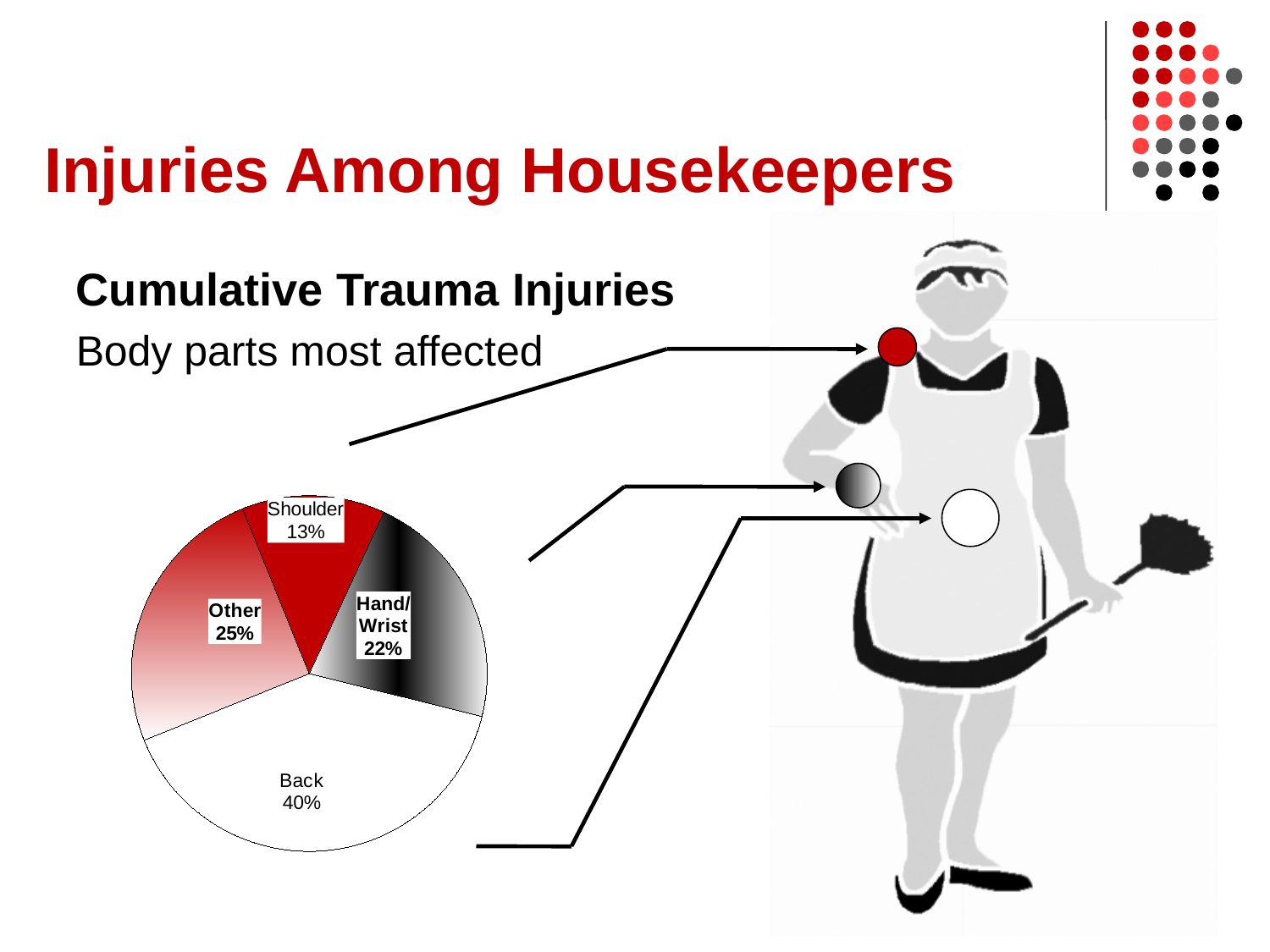
Which is larger, the Other slice or the Shoulder slice? Other What is the difference in percentage points between the Back and Hand/Wrist slices? 18 What is the title of the slide containing the pie chart? Injuries Among Housekeepers What kind of chart is shown on the slide? pie chart How many slices does the pie chart have? 4 What is the difference in percentage points between the Other and Shoulder slices? 12 What percentage of cumulative trauma injuries fall under Other? 25% Which body part has the smallest share of cumulative trauma injuries? Shoulder What percentage of cumulative trauma injuries affect the shoulder? 13% What percentage of cumulative trauma injuries affect the hand/wrist? 22% Which body part has the largest share of cumulative trauma injuries? Back What percentage of cumulative trauma injuries affect the back? 40%